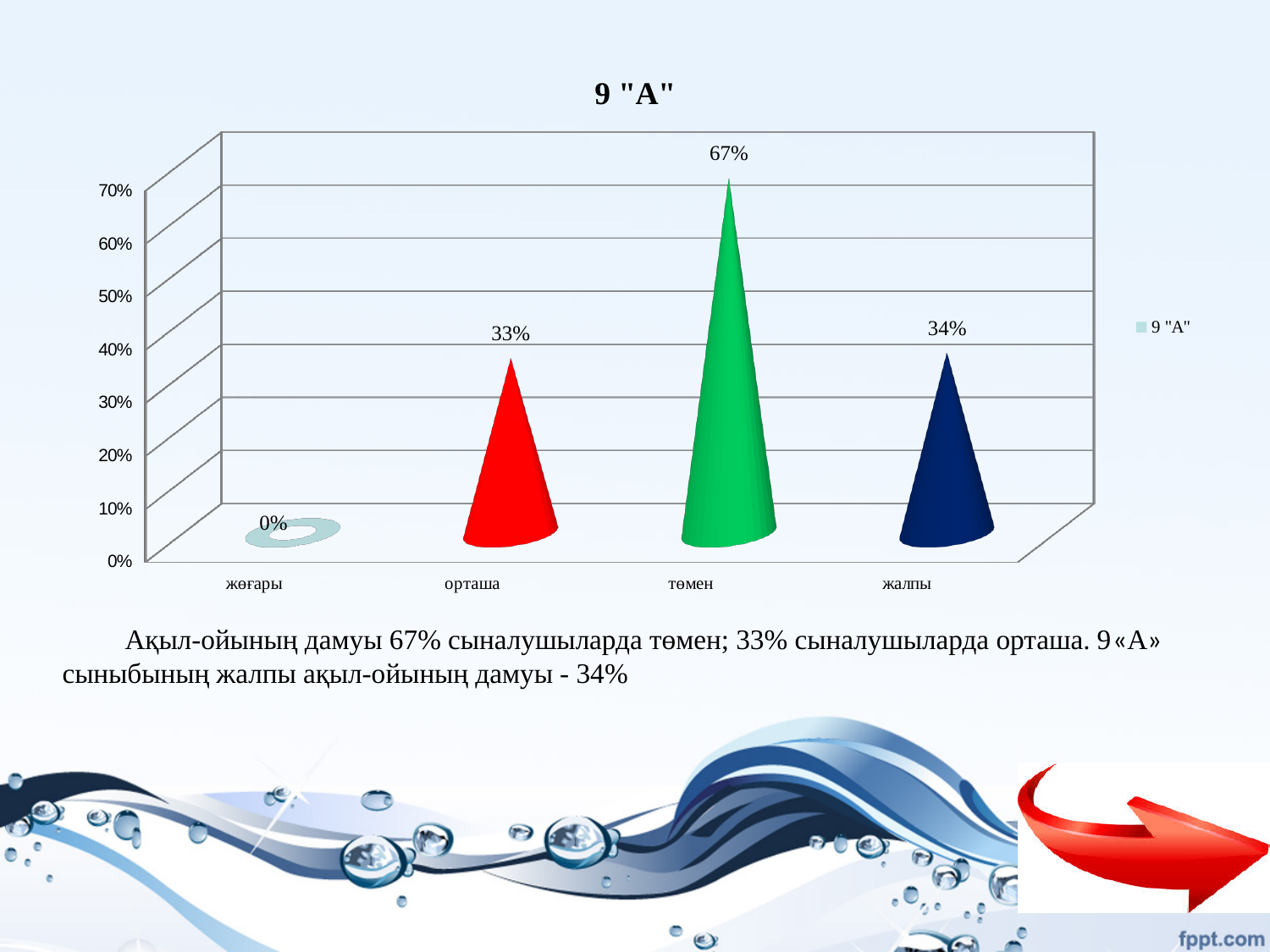
Which category has the lowest value? жоғары What is the value for орташа? 33% What is the value for төмен? 67% What is the value for жалпы? 34% How many categories are shown on the x axis? 4 Is the value for төмен greater or less than 60%? greater What is the value for жоғары? 0% Which category has the highest value? төмен What kind of chart is shown on the slide? bar chart Which is larger, the value for төмен or the value for жалпы? төмен What is the difference between the values for төмен and орташа? 34% What is the title of the chart? 9 "А"